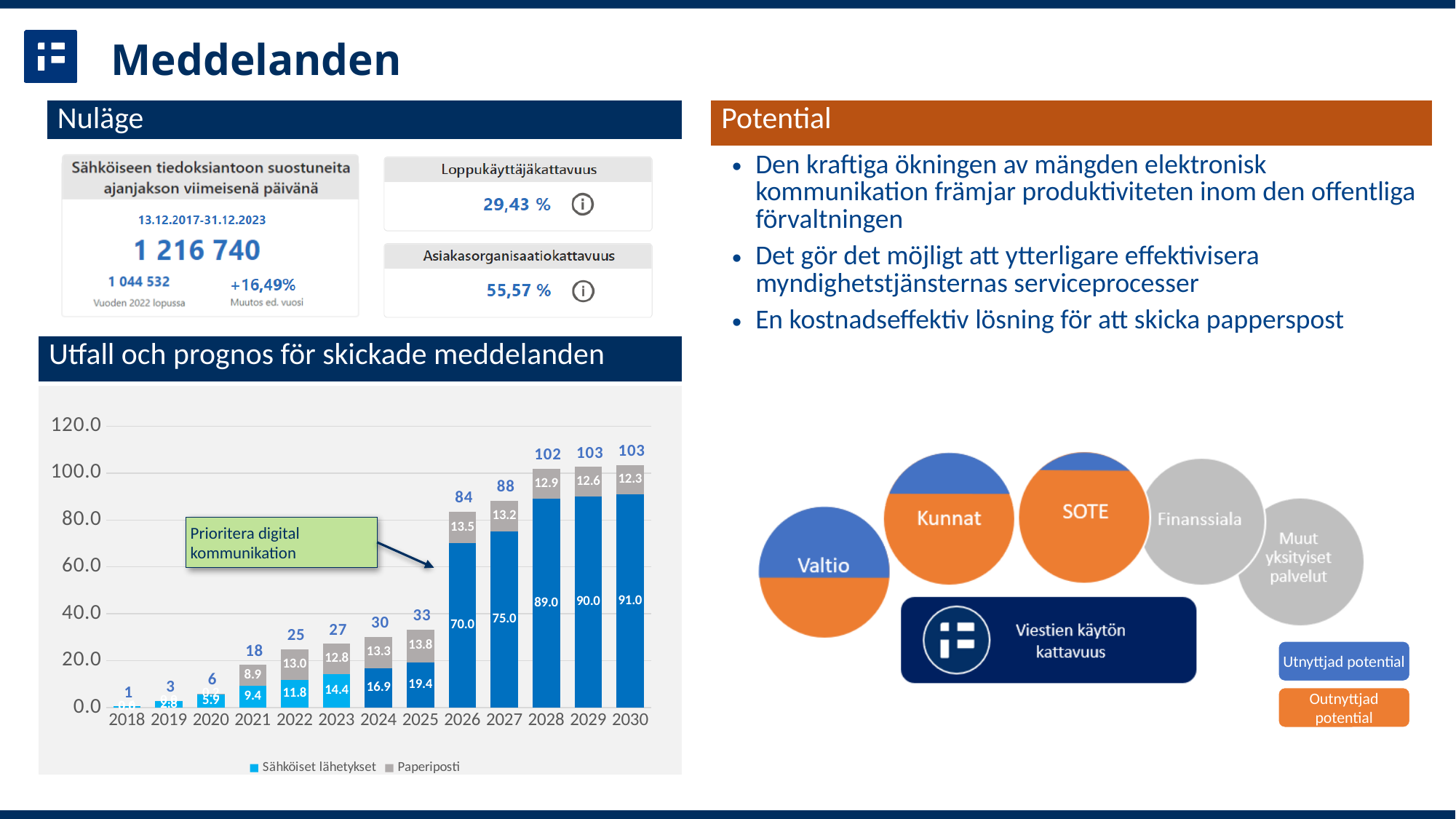
In the 'Utfall och prognos för skickade meddelanden' chart, what is the total labelled above the 2025 bar? 33 In the 'Utfall och prognos för skickade meddelanden' chart, what is the value of Sähköiset lähetykset for 2026? 70.0 How many years are shown on the x axis of the 'Utfall och prognos för skickade meddelanden' chart? 13 In the 'Utfall och prognos för skickade meddelanden' chart, what is the total labelled above the 2030 bar? 103 In the 'Utfall och prognos för skickade meddelanden' chart, what is the difference between the 2026 total and the 2025 total? 51 In the 'Utfall och prognos för skickade meddelanden' chart, which year has the highest Paperiposti value? 2025 In the 'Utfall och prognos för skickade meddelanden' chart, which is larger: Sähköiset lähetykset in 2027 or in 2028? 2028 In the 'Utfall och prognos för skickade meddelanden' chart, which series is shown in blue? Sähköiset lähetykset In the 'Utfall och prognos för skickade meddelanden' chart, what is the value of Paperiposti for 2022? 13.0 What kind of chart is shown under 'Utfall och prognos för skickade meddelanden'? Stacked bar chart How many series does the legend of the 'Utfall och prognos för skickade meddelanden' chart list? 2 In the 'Utfall och prognos för skickade meddelanden' chart, do the total values rise or fall from 2018 to 2030? Rise